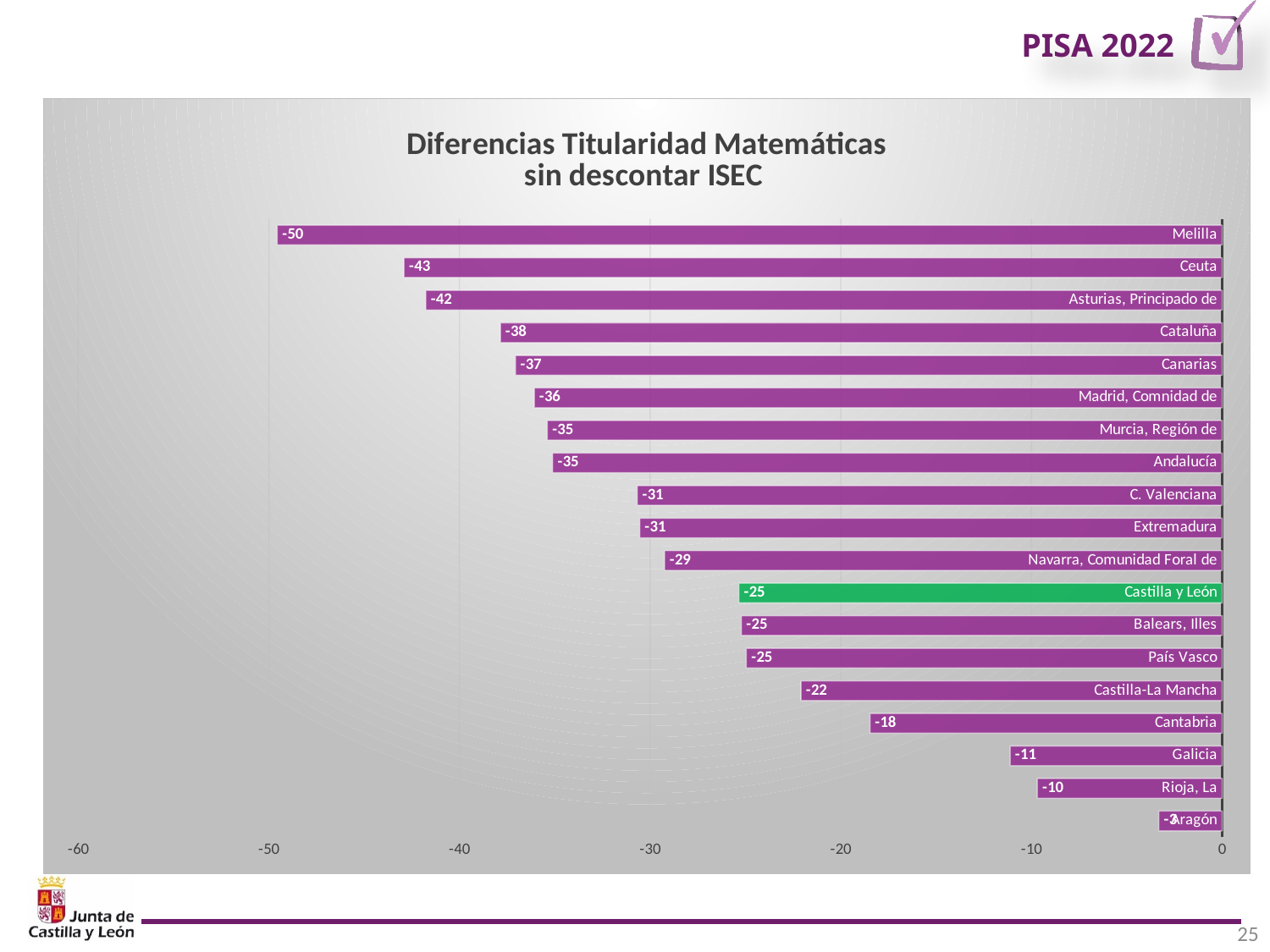
How many categories are shown in the chart? 19 What is the value for Cantabria? -18 What is the value for Castilla y León? -25 What is the value for Galicia? -11 Which category has the lowest (most negative) value? Melilla What is the difference between the values for Melilla and Ceuta? 7 What kind of chart is shown on the slide? Bar chart Which category's bar is coloured green instead of purple? Castilla y León Is the value for Navarra, Comunidad Foral de greater or less than -30? greater What is the value for Melilla? -50 Which has the larger value, Cataluña or Canarias? Canarias Which category has the highest value (closest to zero)? Aragón